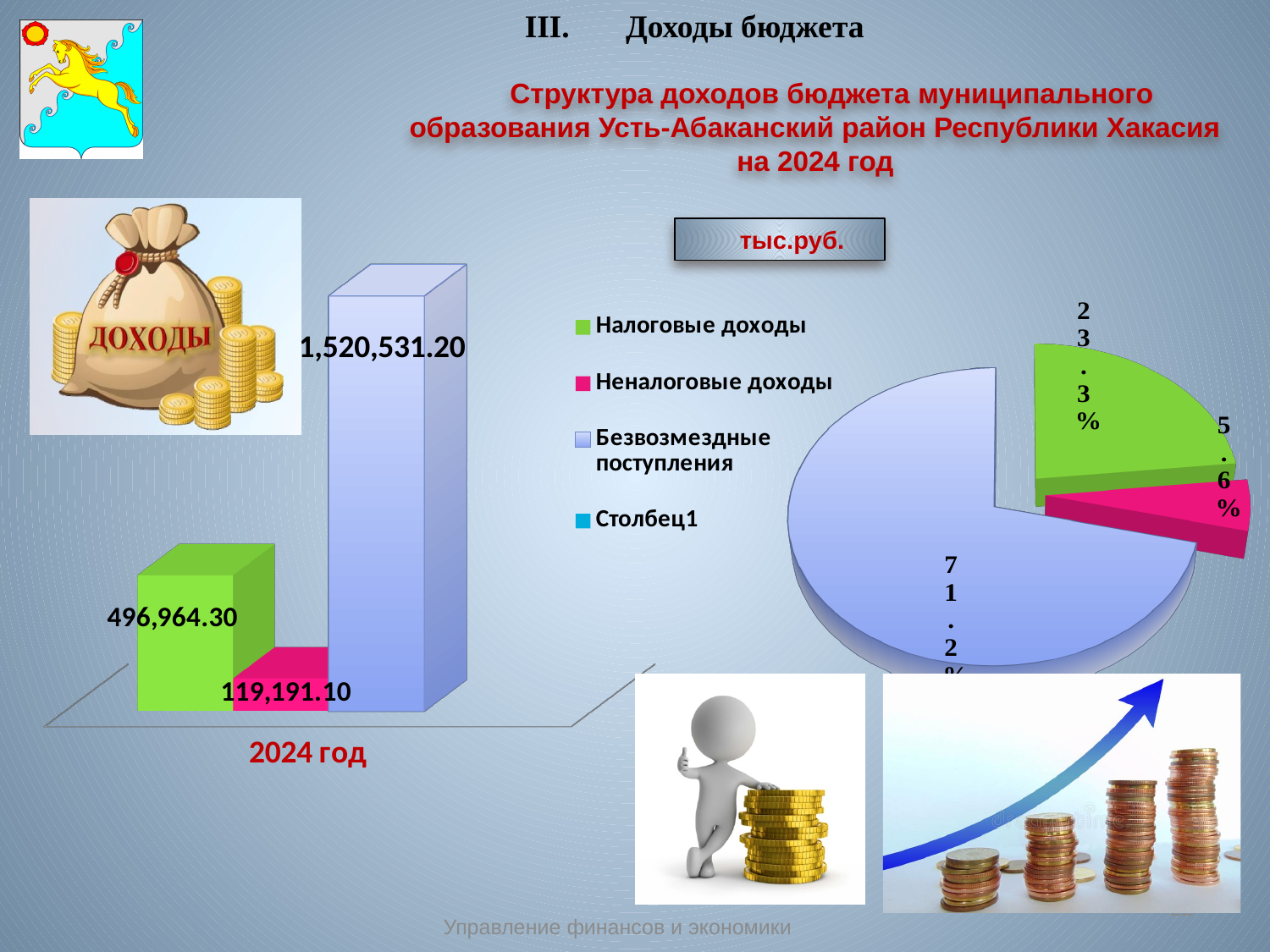
In the bar chart on the left, what is the value for Безвозмездные поступления in 2024 год? 1,520,531.20 In the pie chart on the right, what share does the pink slice (Неналоговые доходы) have? 5.6% In the bar chart on the left, which series has the highest value? Безвозмездные поступления In the bar chart on the left, which series has the lowest value? Неналоговые доходы What kind of chart is shown on the right of the slide? Pie chart In the bar chart on the left, which is larger: Налоговые доходы or Безвозмездные поступления? Безвозмездные поступления How many entries does the legend list? 4 In the bar chart on the left, what is the value for Налоговые доходы in 2024 год? 496,964.30 In the pie chart on the right, what share does the green slice (Налоговые доходы) have? 23.3% In the bar chart on the left, what is the difference between Налоговые доходы and Неналоговые доходы? 377,773.20 In the bar chart on the left, what is the value for Неналоговые доходы in 2024 год? 119,191.10 What kind of chart is shown on the left of the slide? Bar chart